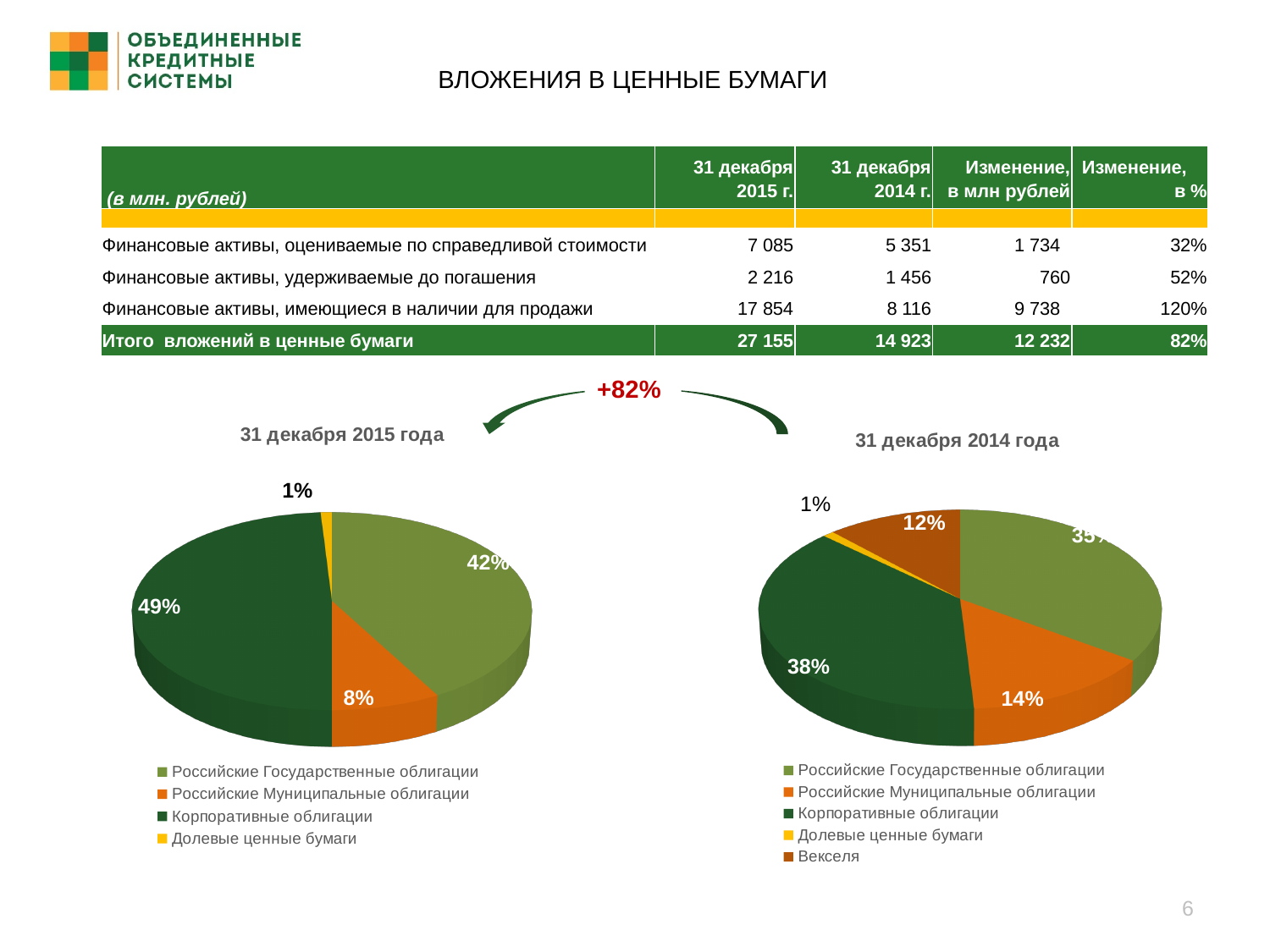
In the '31 декабря 2015 года' chart, what share do Корпоративные облигации have? 49% In the '31 декабря 2015 года' chart, which category has the smallest slice? Долевые ценные бумаги In the '31 декабря 2014 года' chart, what share do Российские Муниципальные облигации have? 14% In the '31 декабря 2015 года' chart, what share do Российские Государственные облигации have? 42% In the '31 декабря 2015 года' chart, which category has the largest slice? Корпоративные облигации In the '31 декабря 2014 года' chart, which is larger: the share of Российские Муниципальные облигации or the share of Векселя? Российские Муниципальные облигации How many categories does the legend of the '31 декабря 2015 года' chart list? 4 In the '31 декабря 2015 года' chart, by how many percentage points does the share of Корпоративные облигации exceed that of Российские Государственные облигации? 7 percentage points How many categories does the legend of the '31 декабря 2014 года' chart list? 5 What kind of chart is the '31 декабря 2015 года' chart? pie chart